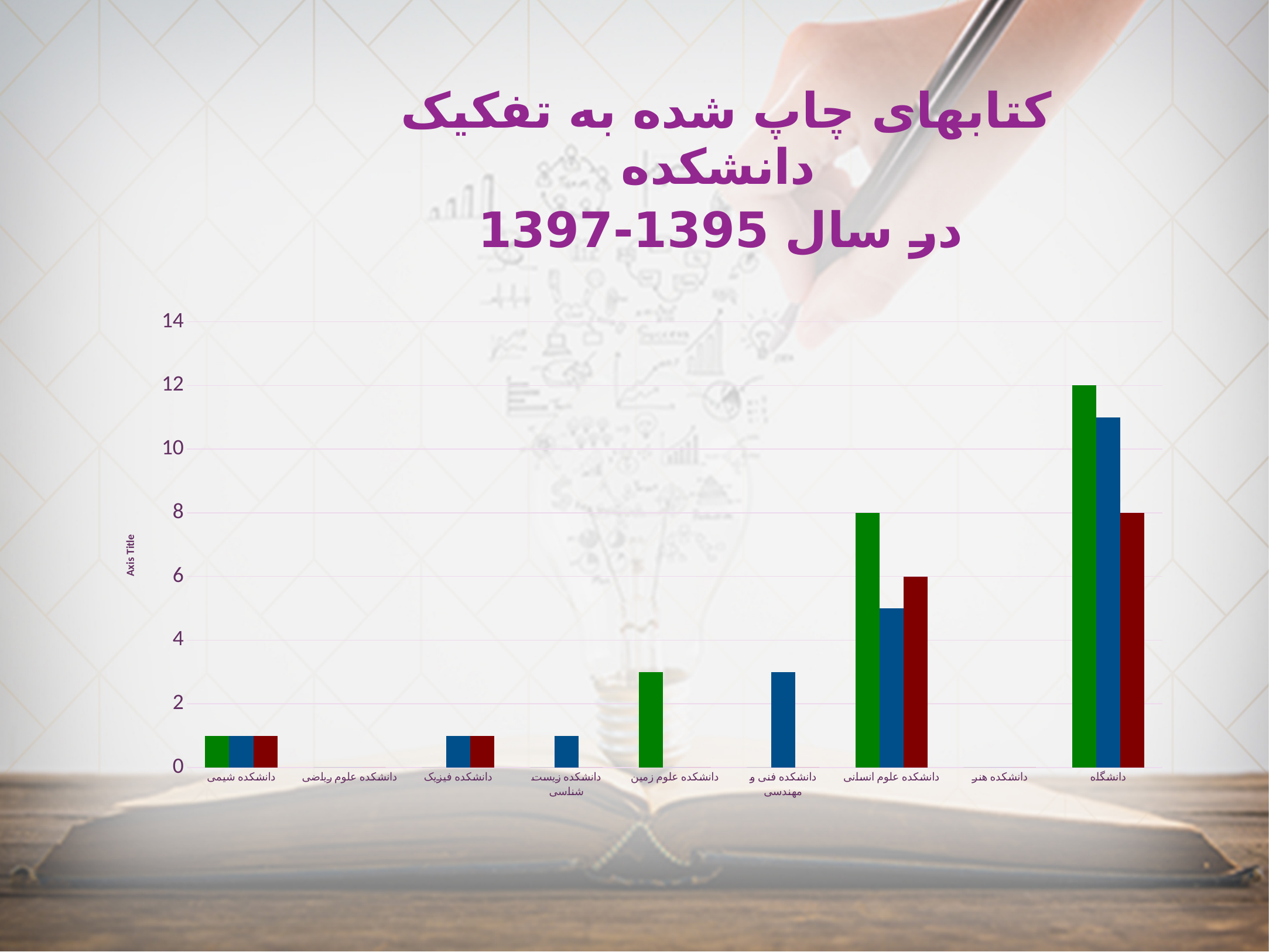
What is the value of the red bar for دانشگاه? 8 What is the value of the green bar for دانشکده علوم انسانی? 8 Is the green bar for دانشکده علوم زمین greater or less than 2? greater Which is larger: the green bar for دانشگاه or the green bar for دانشکده علوم انسانی? دانشگاه What kind of chart is shown on the slide? bar chart What is the difference between the green bar and the red bar for دانشگاه? 4 What is the value of the red bar for دانشکده علوم انسانی? 6 Is the blue bar for دانشگاه greater or less than 10? greater Is the blue bar for دانشکده علوم انسانی greater or less than 6? less Which category has the tallest bar in the chart? دانشگاه How many categories are shown on the x axis of the chart? 9 What is the value of the green bar for دانشگاه? 12